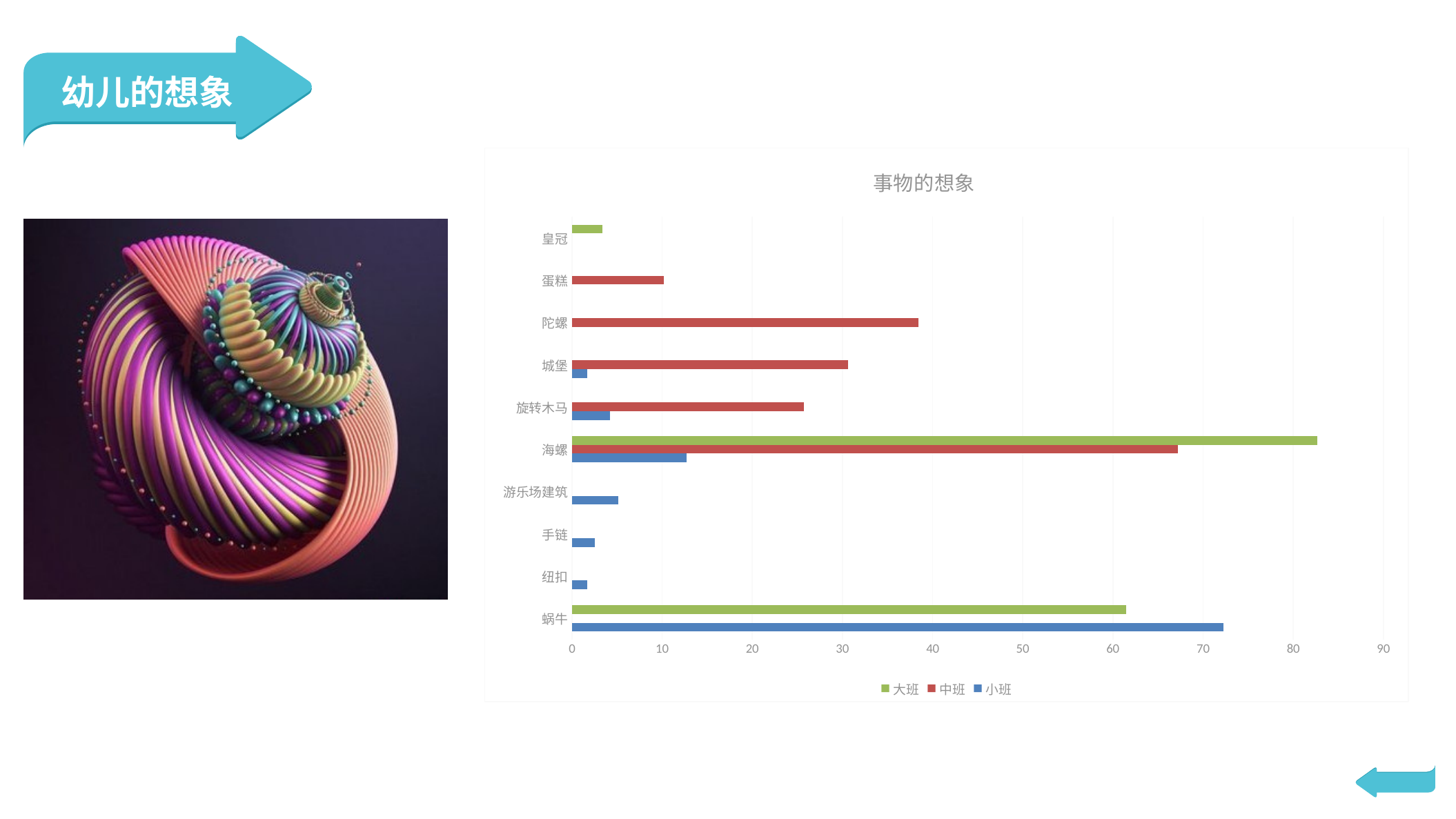
For 海螺, which series has the larger value, 大班 or 中班? 大班 How many series does the legend of the chart list? 3 Is the 中班 value for 陀螺 greater or less than 40? less What is the title of the chart? 事物的想象 Which category has the highest value for the 小班 series? 蜗牛 Which category has the highest value for the 大班 series? 海螺 Which category has the highest value for the 中班 series? 海螺 For 蜗牛, which series has the larger value, 小班 or 大班? 小班 How many categories are shown on the chart's vertical axis? 10 What kind of chart is shown on the slide? bar chart Is the 大班 value for 海螺 greater or less than 80? greater Is the 中班 value for 旋转木马 greater or less than 30? less